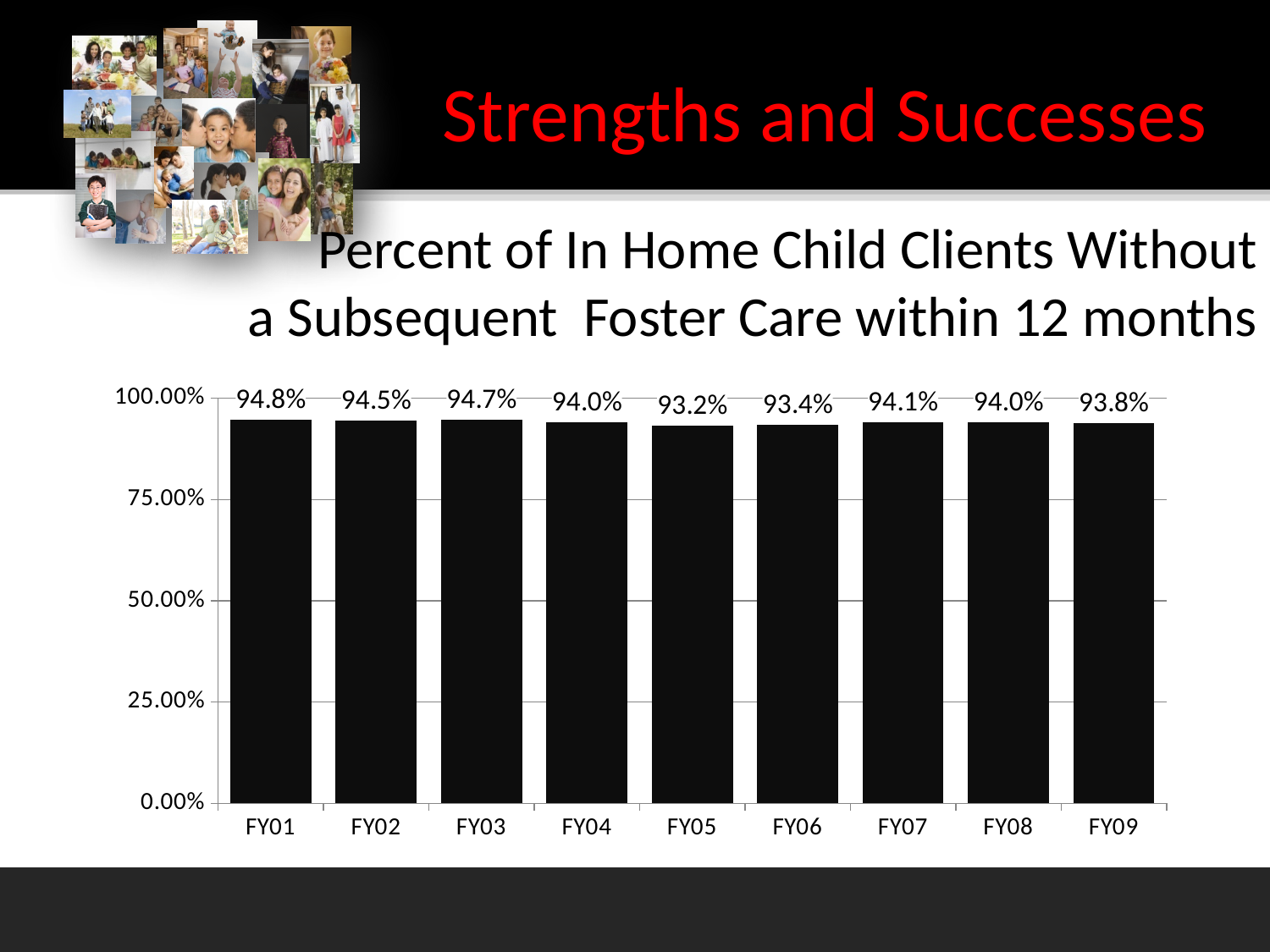
What is the difference between the values for FY01 and FY05? 1.6 percentage points Which is larger, the value for FY03 or the value for FY06? FY03 What is the value for FY05? 93.2% Which fiscal year has the lowest value? FY05 Which fiscal year has the highest value? FY01 What is the value for FY09? 93.8% Do the values rise or fall from FY03 to FY05? fall What kind of chart is shown on the slide? bar chart What is the value for FY01? 94.8% How many fiscal years are shown on the x axis? 9 What is the title of the chart? Percent of In Home Child Clients Without a Subsequent Foster Care within 12 months Is the value for FY07 greater or less than 75.00%? greater